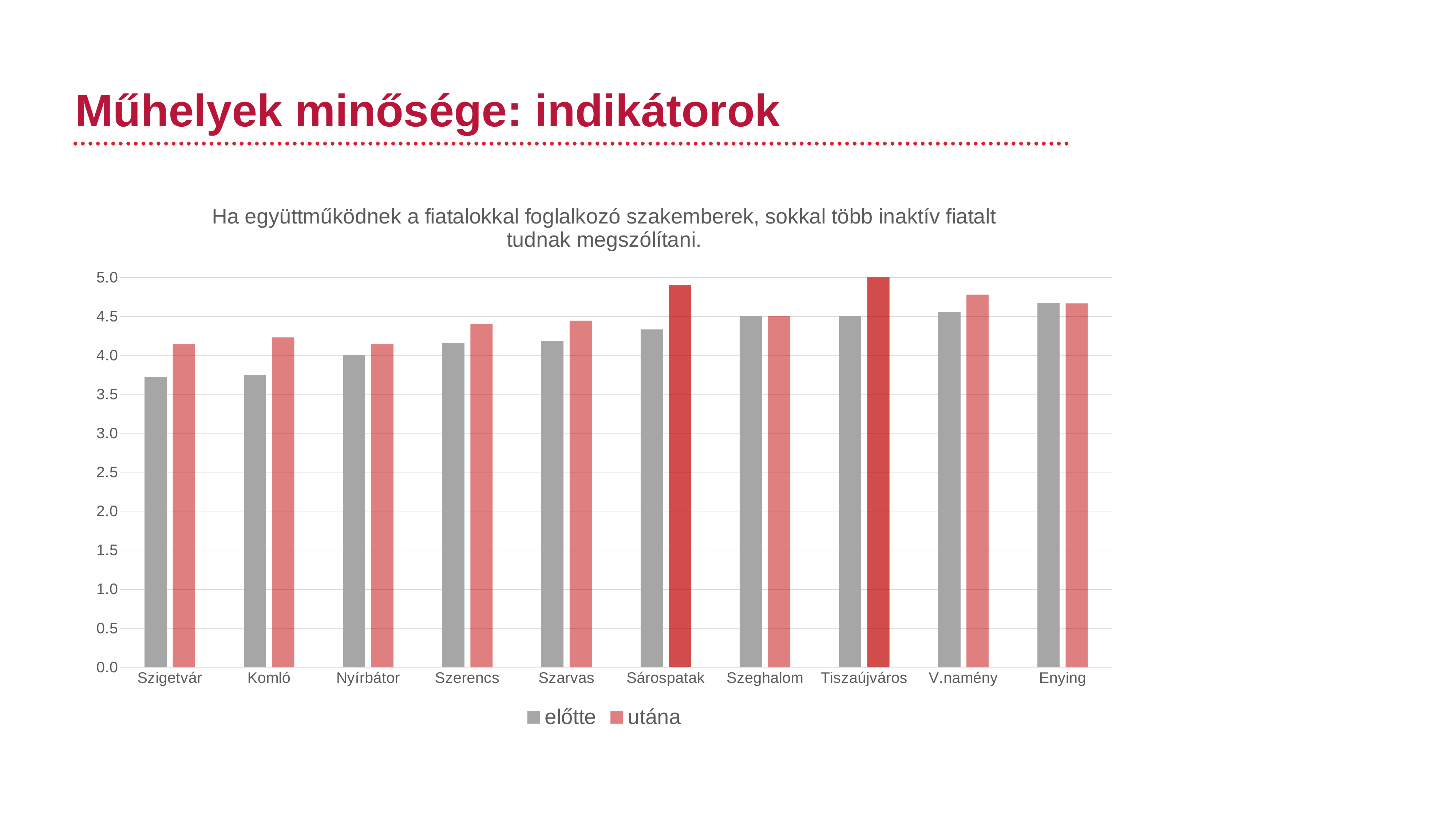
What is the 'előtte' value for Nyírbátor? 4.0 What is the 'utána' value for Tiszaújváros? 5.0 What are the two series named in the chart's legend? előtte and utána What kind of chart is shown on the slide? bar chart How many categories (towns) are shown on the x axis of the chart? 10 Is the 'előtte' value for Szigetvár greater or less than 4.0? less Which town has the highest 'előtte' value in the chart? Enying Which town has the highest 'utána' value in the chart? Tiszaújváros How many series does the chart's legend list? 2 Which series is drawn in grey in the chart? előtte For Sárospatak, which is larger: the 'előtte' value or the 'utána' value? utána Is the 'utána' value for Sárospatak greater or less than 4.5? greater